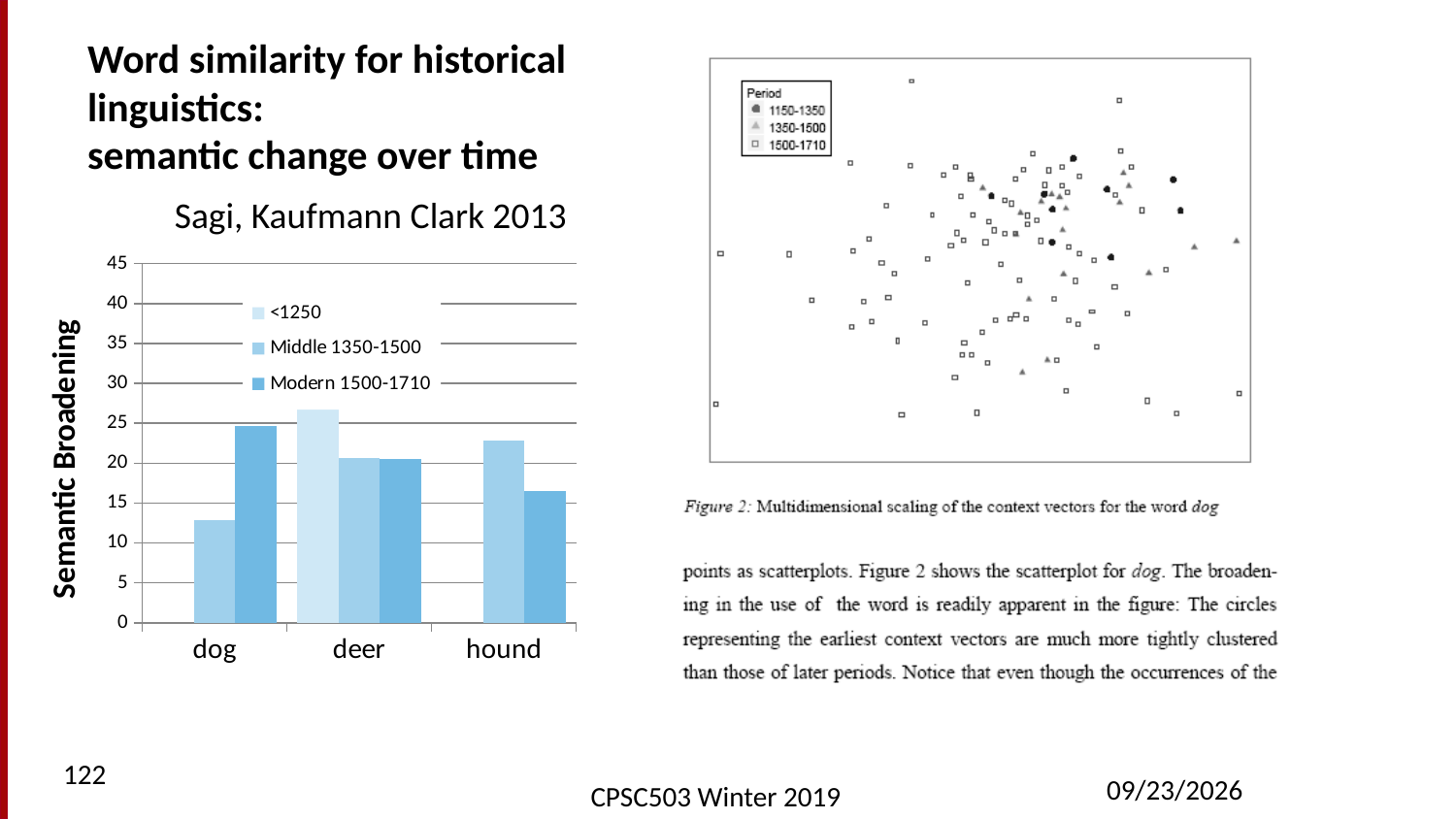
In the bar chart on the left, which is larger for dog: the Middle 1350-1500 value or the Modern 1500-1710 value? Modern 1500-1710 In the bar chart on the left, is the <1250 value for deer greater or less than 25? greater In the bar chart on the left, is the Middle 1350-1500 value for dog greater or less than 15? less In the bar chart on the left, which category has the highest <1250 bar? deer In the bar chart on the left, which is larger for hound: the Middle 1350-1500 value or the Modern 1500-1710 value? Middle 1350-1500 What is the y-axis label of the bar chart on the left? Semantic Broadening How many periods does the legend of the scatterplot on the right list? 3 How many categories are shown on the x axis of the bar chart on the left? 3 What kind of chart is the chart on the left of the slide? bar chart In the bar chart on the left, is the Modern 1500-1710 value for dog greater or less than 20? greater How many series does the legend of the bar chart on the left list? 3